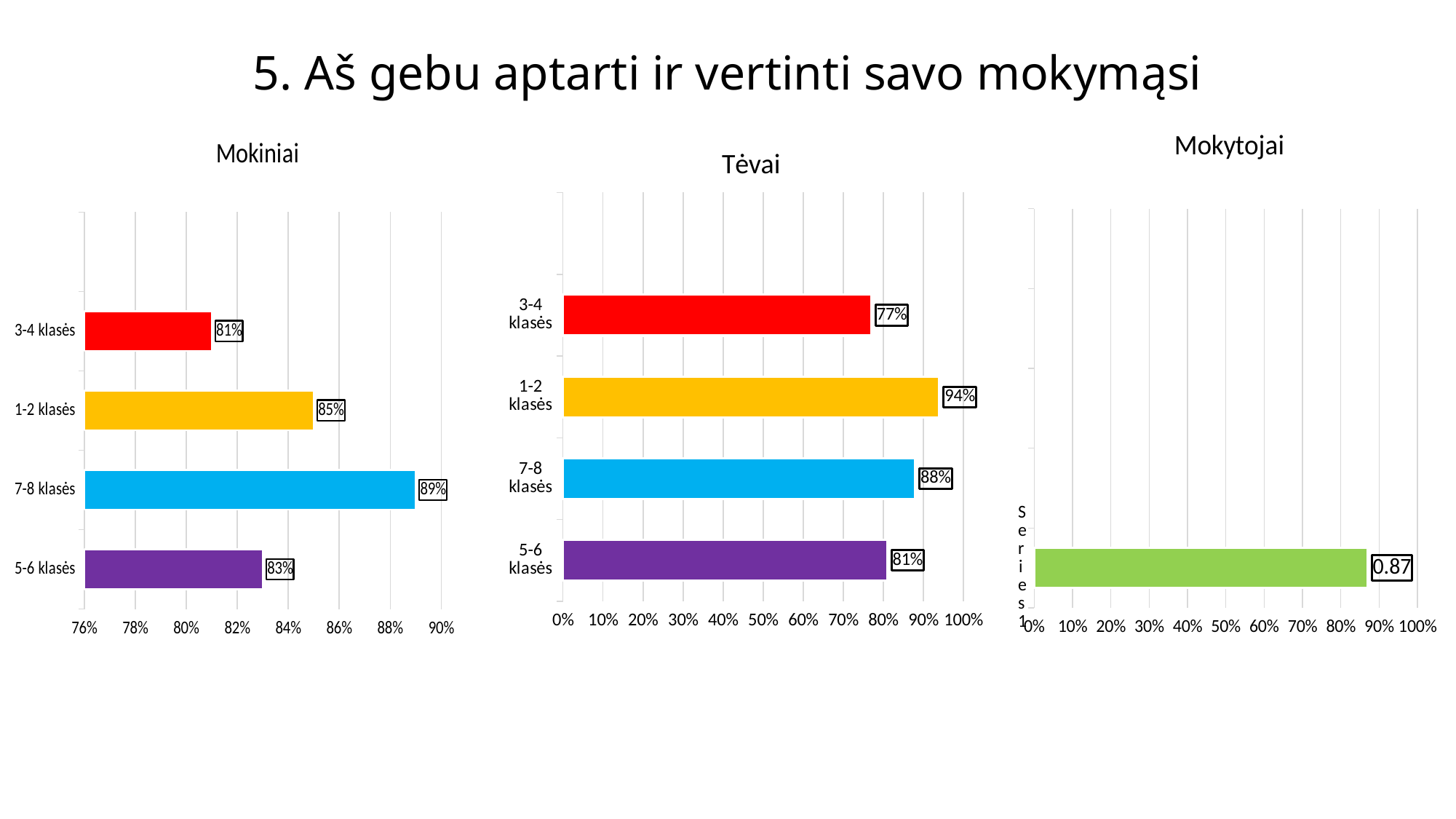
In the Mokytojai chart, what value is printed on the bar? 0.87 In the Mokiniai chart, which category has the lowest value? 3-4 klasės In the Mokiniai chart, what is the value for 7-8 klasės? 89% In the Tėvai chart, which category has the lowest value? 3-4 klasės In the Tėvai chart, which is larger: the value for 7-8 klasės or the value for 5-6 klasės? 7-8 klasės In the Tėvai chart, what is the value for 1-2 klasės? 94% In the Mokiniai chart, how many categories are shown? 4 In the Tėvai chart, which category has the highest value? 1-2 klasės In the Tėvai chart, what is the difference between the values for 1-2 klasės and 5-6 klasės? 13% What kind of chart is the Tėvai chart? Bar chart What is the title of the chart on the right of the slide? Mokytojai In the Mokiniai chart, what is the difference between the values for 7-8 klasės and 3-4 klasės? 8%